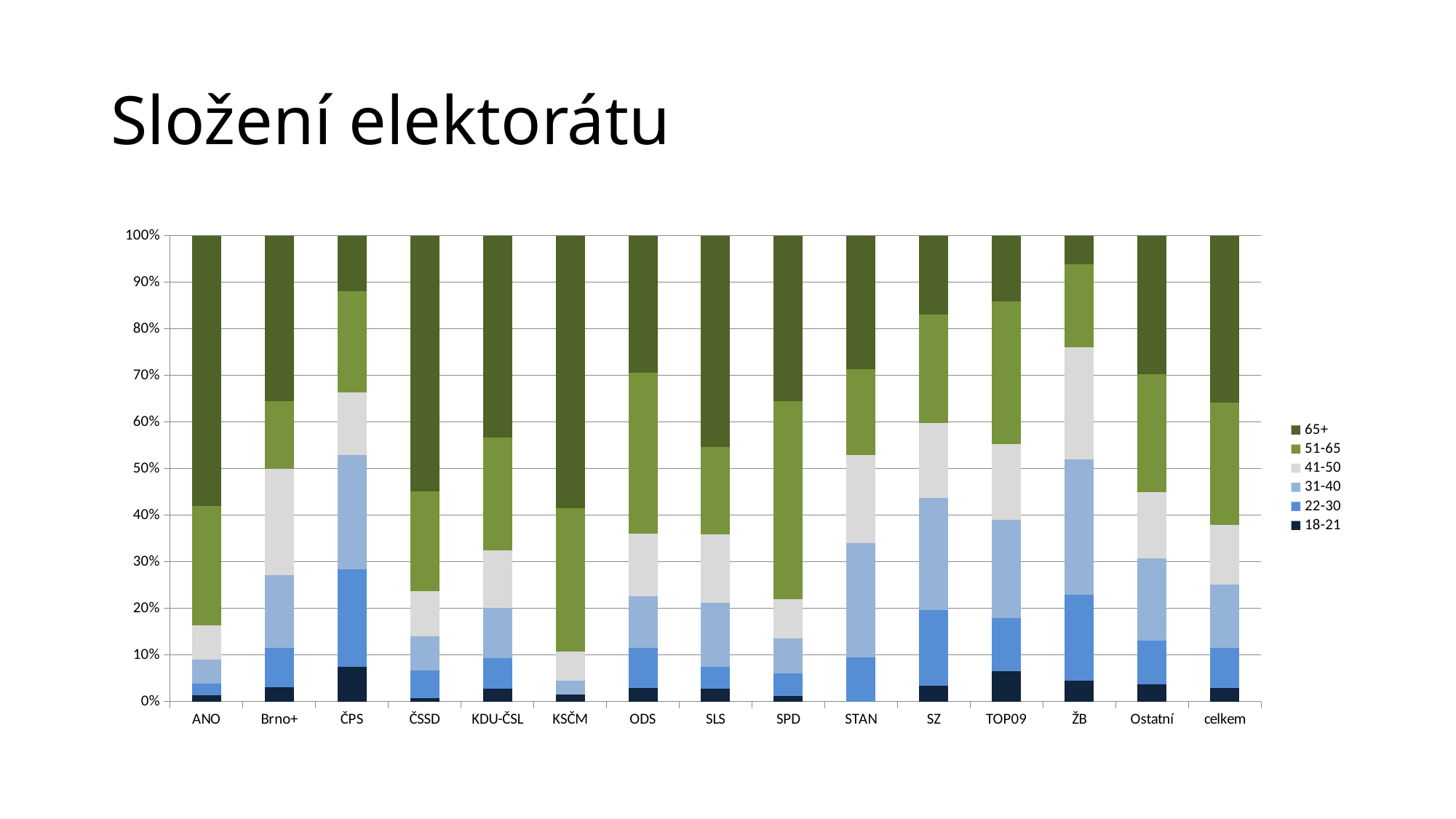
Which category has the largest share of the 22-30 age group? ČPS Which age group is listed first (at the top) in the chart's legend? 65+ How many categories (bars) are shown along the x axis of the chart? 15 How many series does the legend of the chart list? 6 Is the share of the 65+ age group for ČPS greater or less than 20%? less Which has a larger share of the 65+ age group, ANO or ČPS? ANO Is the share of the 65+ age group for ANO greater or less than 50%? greater What is the title of the slide with the chart? Složení elektorátu Is the share of the 65+ age group for KSČM greater or less than 50%? greater What kind of chart is shown on the slide? Stacked bar chart Which category has the smallest share of the 65+ age group? ŽB